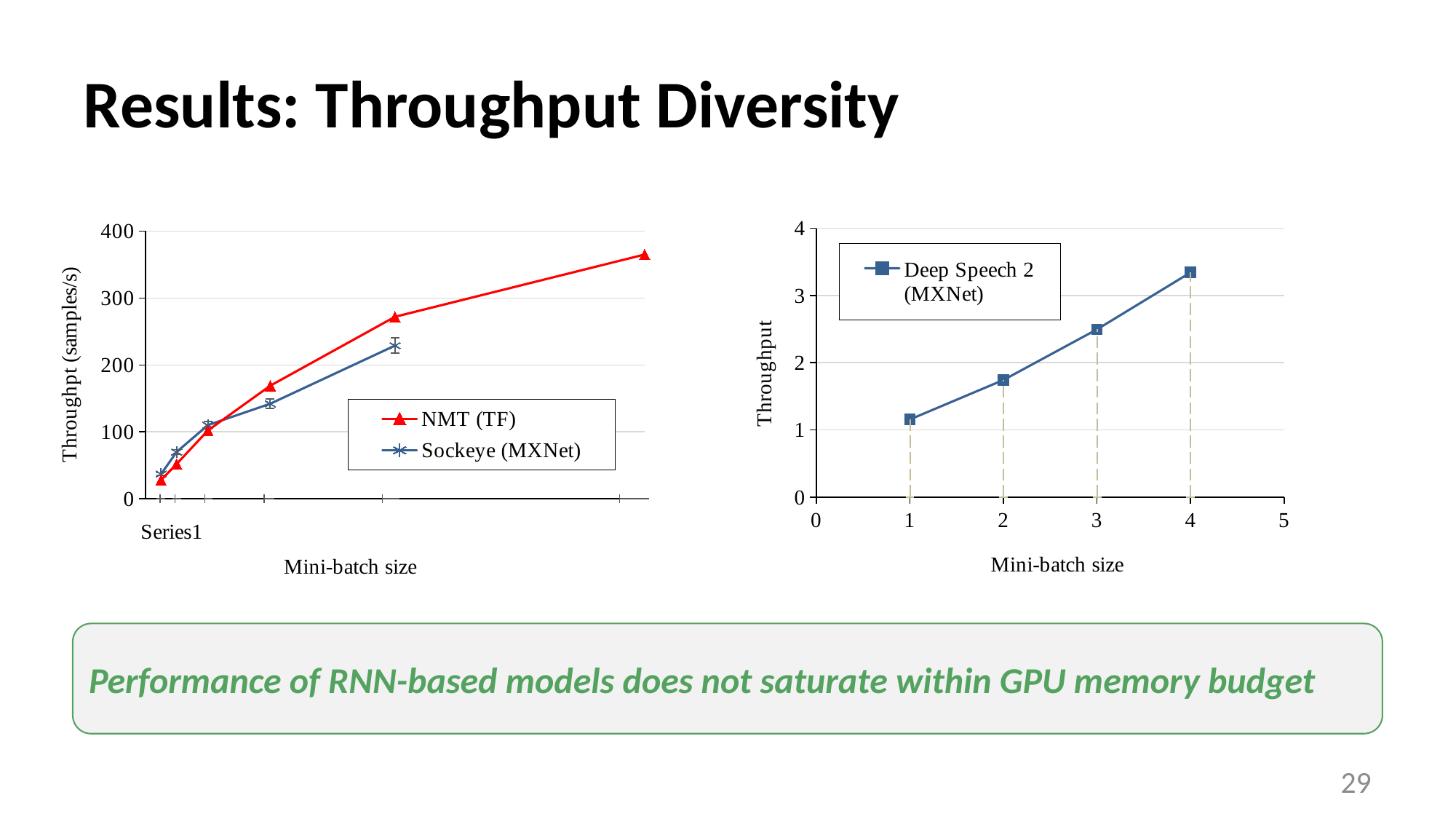
In the left chart, is the highest value for NMT (TF) greater or less than 300? greater In the right chart, is the throughput for Deep Speech 2 (MXNet) at mini-batch size 2 greater or less than 2? less In the right chart, how many data points are plotted for Deep Speech 2 (MXNet)? 4 Which series are listed in the legend of the left chart? NMT (TF) and Sockeye (MXNet) In the right chart, is the throughput for Deep Speech 2 (MXNet) at mini-batch size 4 greater or less than 3? greater What is the y-axis label of the left chart? Throughpt (samples/s) How many series does the legend of the left chart list? 2 What type of chart is the left chart? line chart In the left chart, which series reaches the higher throughput overall, NMT (TF) or Sockeye (MXNet)? NMT (TF) In the left chart, does throughput rise or fall as mini-batch size increases? rise In the right chart, does throughput rise or fall as mini-batch size increases from 1 to 4? rise